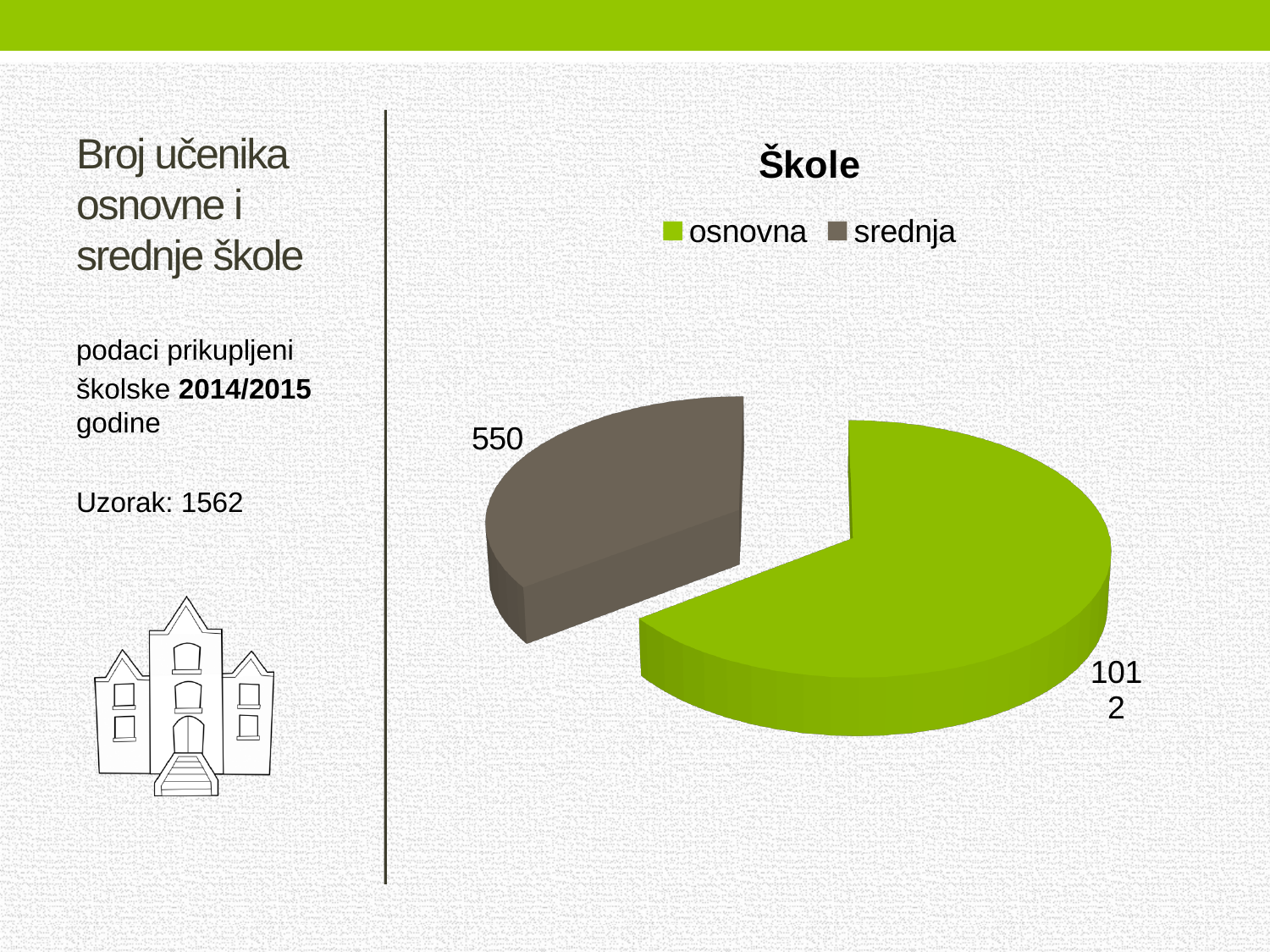
Which colour represents srednja in the pie chart? grey How many slices does the pie chart have? 2 What type of chart is shown on the slide? pie chart How many entries does the legend list? 2 What is the difference between the value for osnovna and the value for srednja? 462 What is the total of the two slices in the pie chart? 1562 What is the title of the chart? Škole Which category has the largest slice in the pie chart? osnovna What is the value for srednja in the pie chart? 550 Which is larger, the value for osnovna or the value for srednja? osnovna What is the value for osnovna in the pie chart? 1012 Which category has the smallest slice in the pie chart? srednja